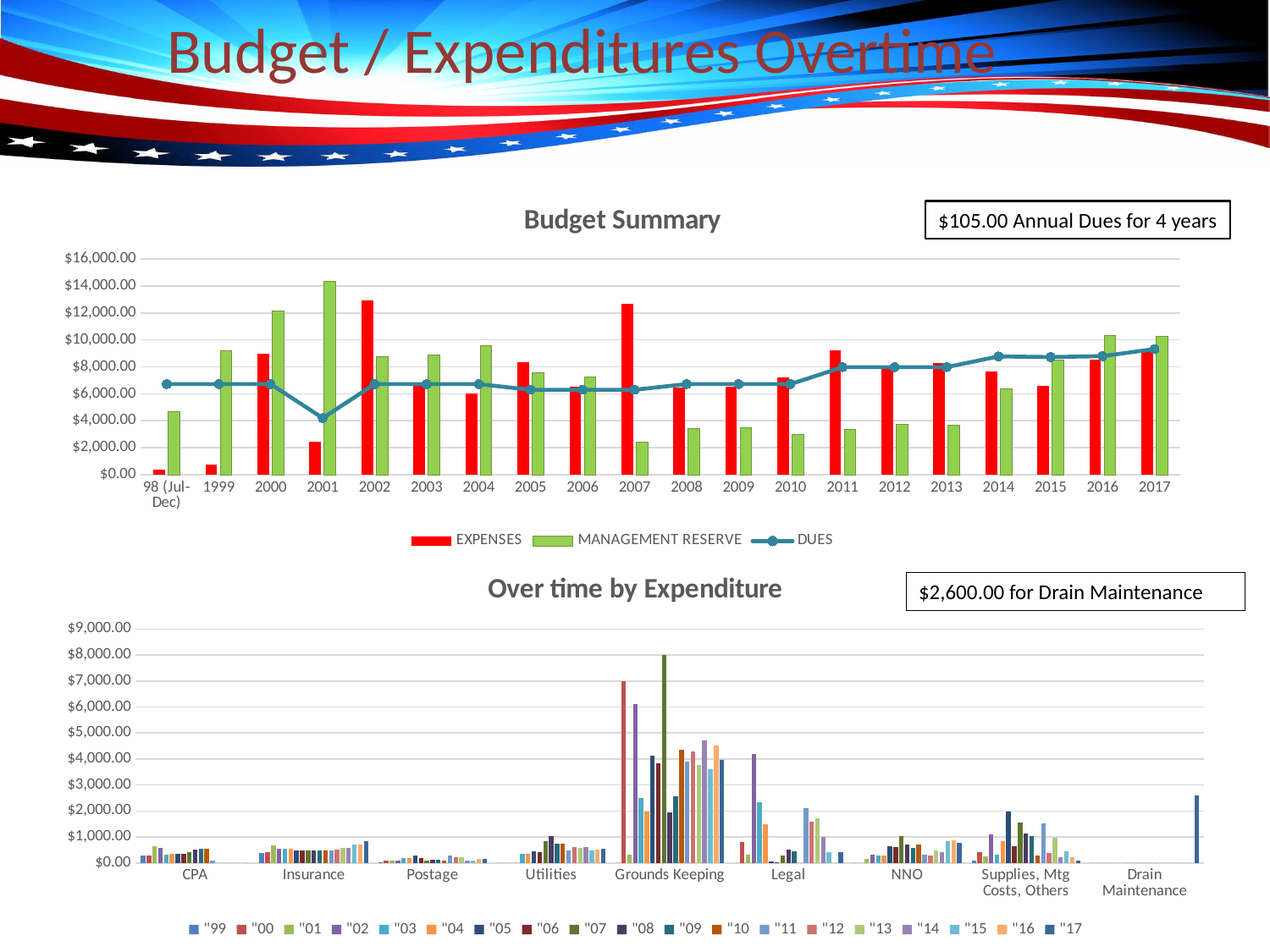
In the Budget Summary chart, how many year categories are shown on the x axis? 20 In the Budget Summary chart, which year has the highest MANAGEMENT RESERVE bar? 2001 In the Over time by Expenditure chart, how many series does the legend list? 19 In the Budget Summary chart, does the DUES line generally rise or fall from 98 (Jul-Dec) to 2017? rise In the Over time by Expenditure chart, how many expenditure categories are shown on the x axis? 9 In the Budget Summary chart, is the MANAGEMENT RESERVE value for 2001 greater or less than $12,000.00? greater In the Budget Summary chart, which is larger in 2001: EXPENSES or MANAGEMENT RESERVE? MANAGEMENT RESERVE What is the title of the top chart on the slide? Budget Summary In the Budget Summary chart, which category has the lowest EXPENSES bar? 98 (Jul-Dec) In the Budget Summary chart, how many series does the legend list? 3 What kind of chart is the Over time by Expenditure chart? bar chart In the Budget Summary chart, is the MANAGEMENT RESERVE value for 2010 greater or less than $4,000.00? less